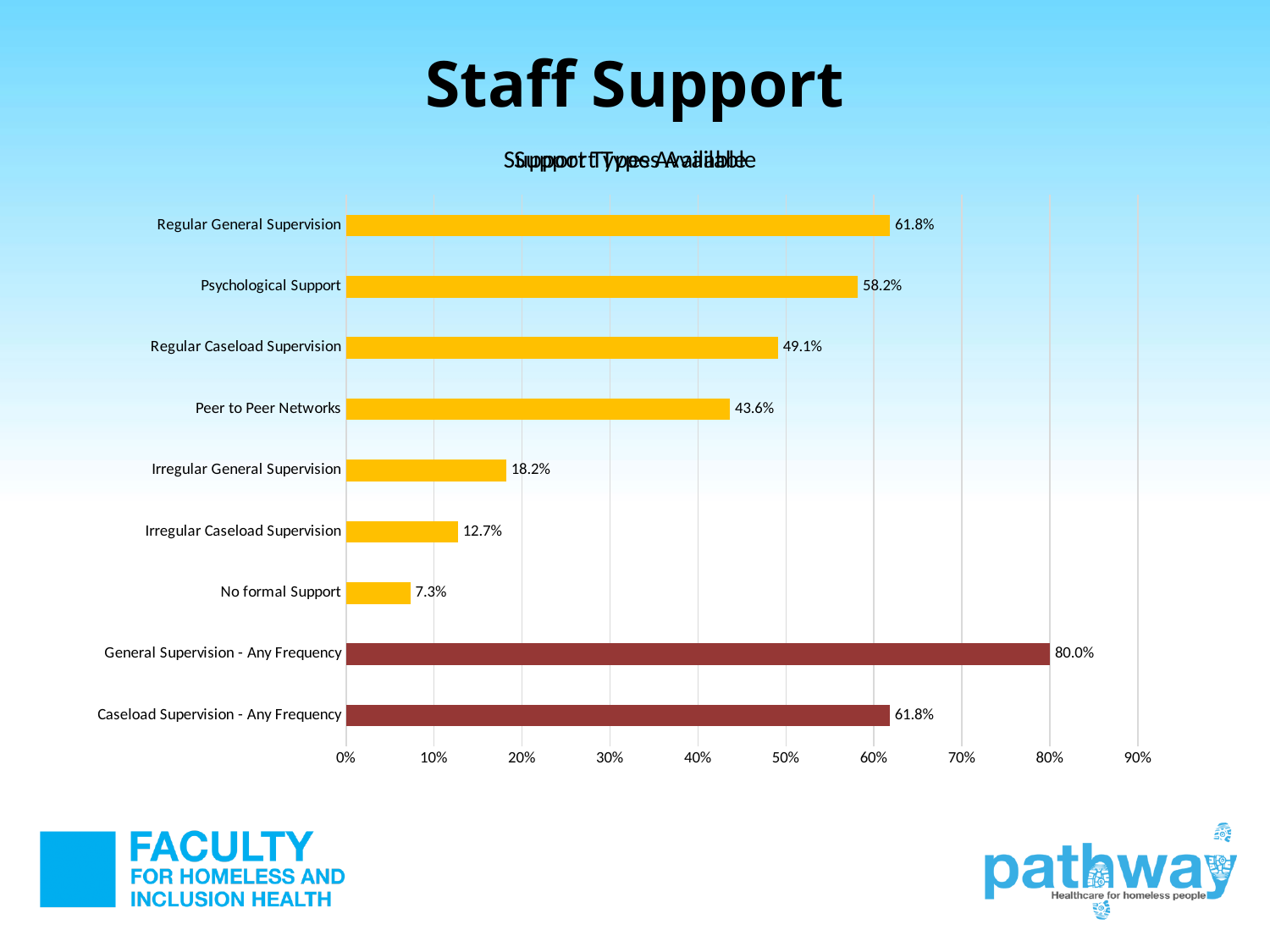
What is the value for No formal Support? 7.3% What colour are the bars for the two 'Any Frequency' categories? dark red What is the value for General Supervision - Any Frequency? 80.0% What is the difference between Psychological Support and Regular Caseload Supervision? 9.1% Which is larger, Irregular General Supervision or Irregular Caseload Supervision? Irregular General Supervision Which category has the lowest value? No formal Support How many categories are shown in the chart? 9 Is the value for Regular Caseload Supervision greater or less than 50%? less Which category has the highest value? General Supervision - Any Frequency What kind of chart is shown on the slide? bar chart What is the value for Peer to Peer Networks? 43.6% What is the value for Regular General Supervision? 61.8%